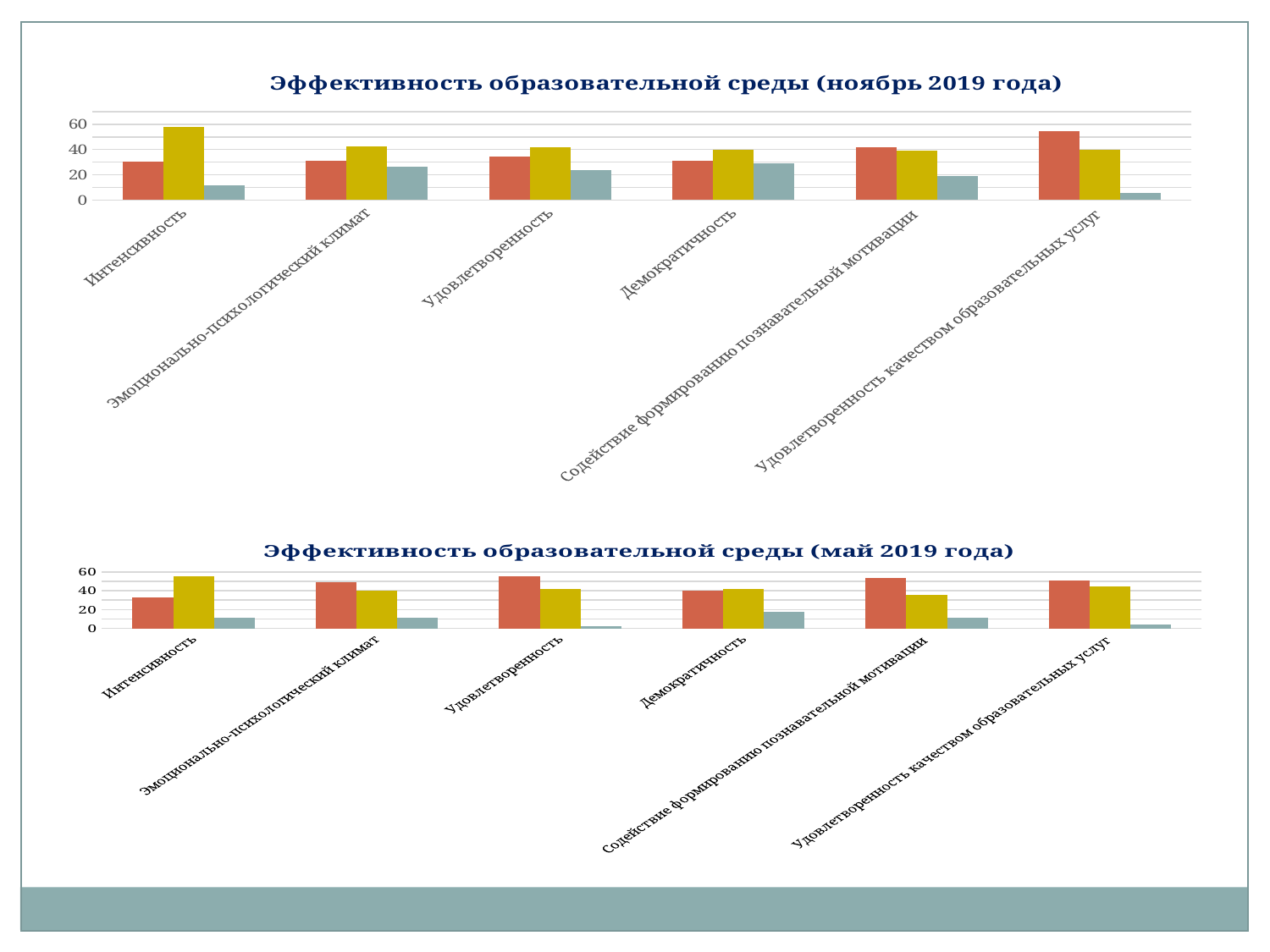
What is the title of the bottom chart on the slide? Эффективность образовательной среды (май 2019 года) In the bottom chart (май 2019 года), which is larger for Содействие формированию познавательной мотивации: the red bar or the yellow bar? the red bar In the top chart (ноябрь 2019 года), is the blue-grey bar for Удовлетворенность качеством образовательных услуг greater or less than 20? less In the top chart (ноябрь 2019 года), which is larger for Интенсивность: the red bar or the yellow bar? the yellow bar How many categories are shown on the x axis of the bottom chart (май 2019 года)? 6 In the bottom chart (май 2019 года), is the blue-grey bar for Демократичность greater or less than 40? less In the top chart (ноябрь 2019 года), which category has the lowest blue-grey bar? Удовлетворенность качеством образовательных услуг In the top chart (ноябрь 2019 года), which category has the highest red bar? Удовлетворенность качеством образовательных услуг What kind of chart is the top chart titled "Эффективность образовательной среды (ноябрь 2019 года)"? bar chart In the bottom chart (май 2019 года), which category has the lowest blue-grey bar? Удовлетворенность In the bottom chart (май 2019 года), is the red bar for Удовлетворенность greater or less than 40? greater